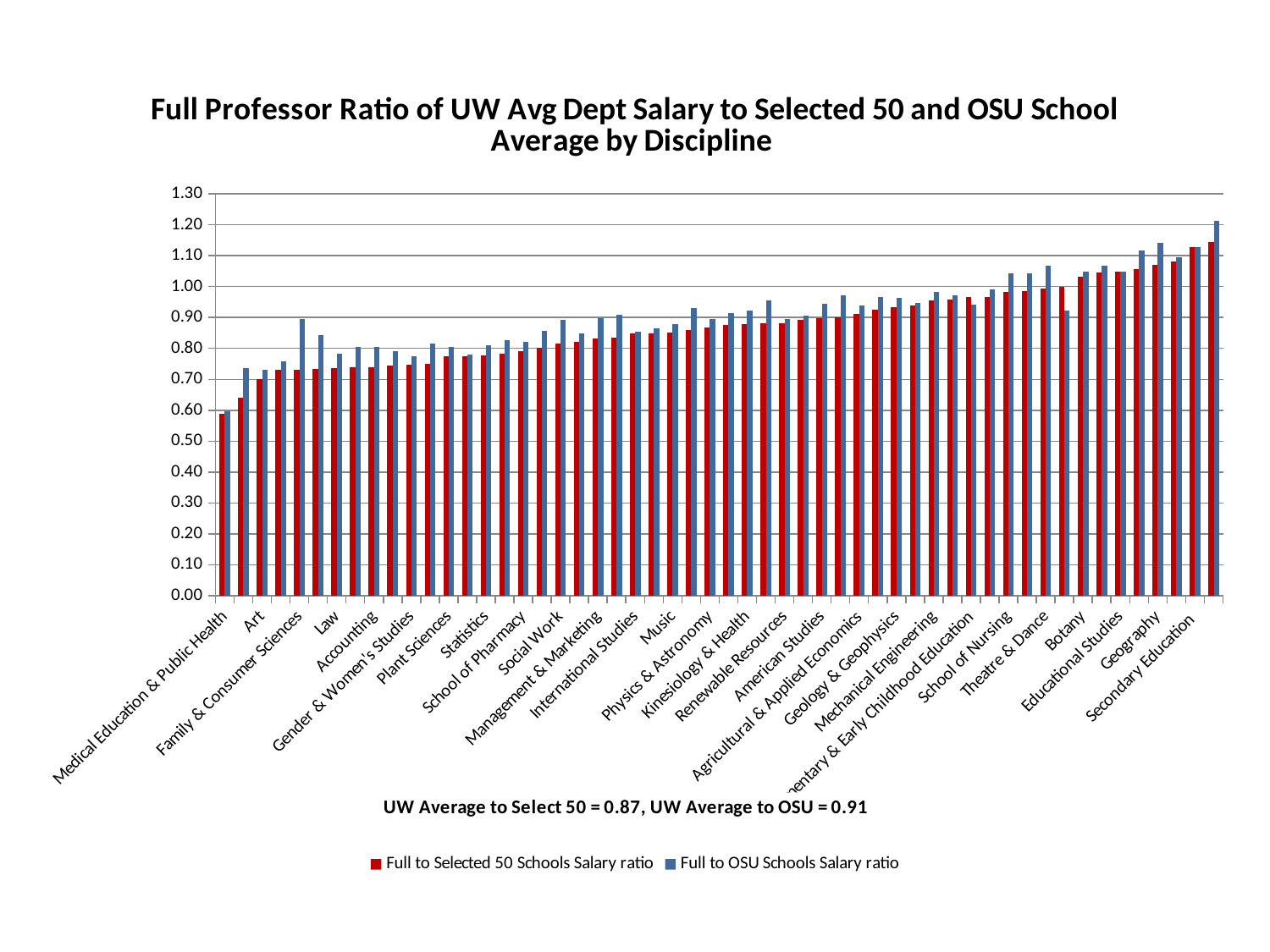
What are the two series named in the legend? Full to Selected 50 Schools Salary ratio; Full to OSU Schools Salary ratio Do the Full to Selected 50 Schools Salary ratio values generally rise or fall from left to right along the x axis? Rise Is the Full to Selected 50 Schools Salary ratio for Secondary Education greater or less than 1.00? greater Which discipline has the lowest Full to Selected 50 Schools Salary ratio? Medical Education & Public Health Which has the larger Full to Selected 50 Schools Salary ratio: Medical Education & Public Health or Secondary Education? Secondary Education Is the Full to Selected 50 Schools Salary ratio for Medical Education & Public Health greater or less than 0.70? less How many series does the legend list? 2 What note is printed below the x axis about the UW averages? UW Average to Select 50 = 0.87, UW Average to OSU = 0.91 What kind of chart is shown on the slide? Bar chart Is the Full to Selected 50 Schools Salary ratio for Art greater or less than 0.80? less For Family & Consumer Sciences, which is larger: the Full to Selected 50 Schools Salary ratio or the Full to OSU Schools Salary ratio? Full to OSU Schools Salary ratio